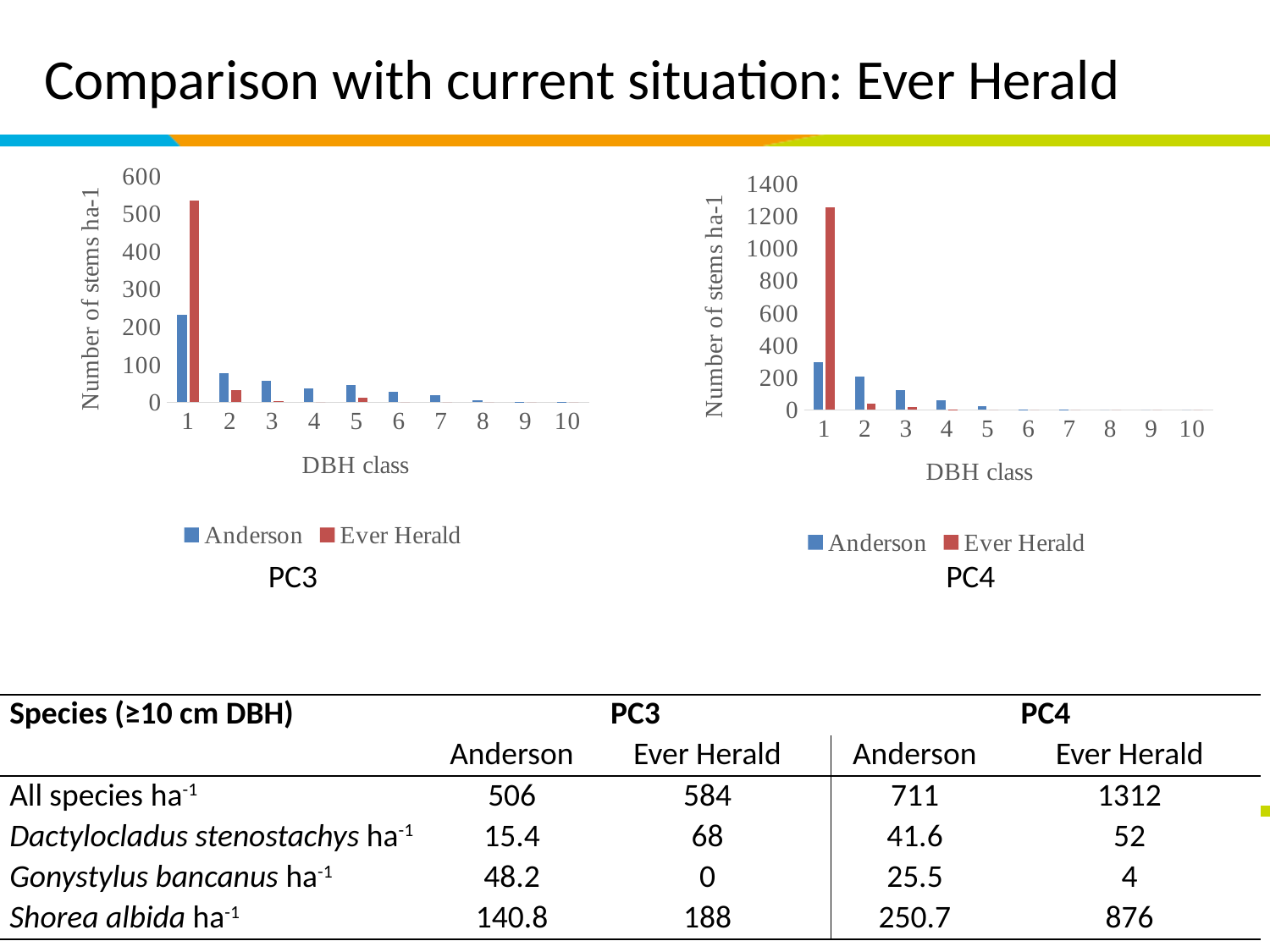
In the PC4 chart, which series has the larger value for DBH class 1, Anderson or Ever Herald? Ever Herald In the PC3 chart, is the Anderson value for DBH class 1 greater or less than 300? less In the PC3 chart, which DBH class has the highest Ever Herald value? 1 In the PC4 chart, is the Ever Herald value for DBH class 1 greater or less than 1200? greater How many DBH classes are shown on the x axis of the PC3 chart? 10 In the PC4 chart, is the Anderson value for DBH class 3 greater or less than 200? less What is the y-axis label of the PC3 chart? Number of stems ha-1 In the PC3 chart, which series has the larger value for DBH class 2, Anderson or Ever Herald? Anderson In the PC4 chart, do the Anderson values generally rise or fall as DBH class increases? fall What kind of chart is the PC3 chart on the left? bar chart How many series does the legend of the PC4 chart list? 2